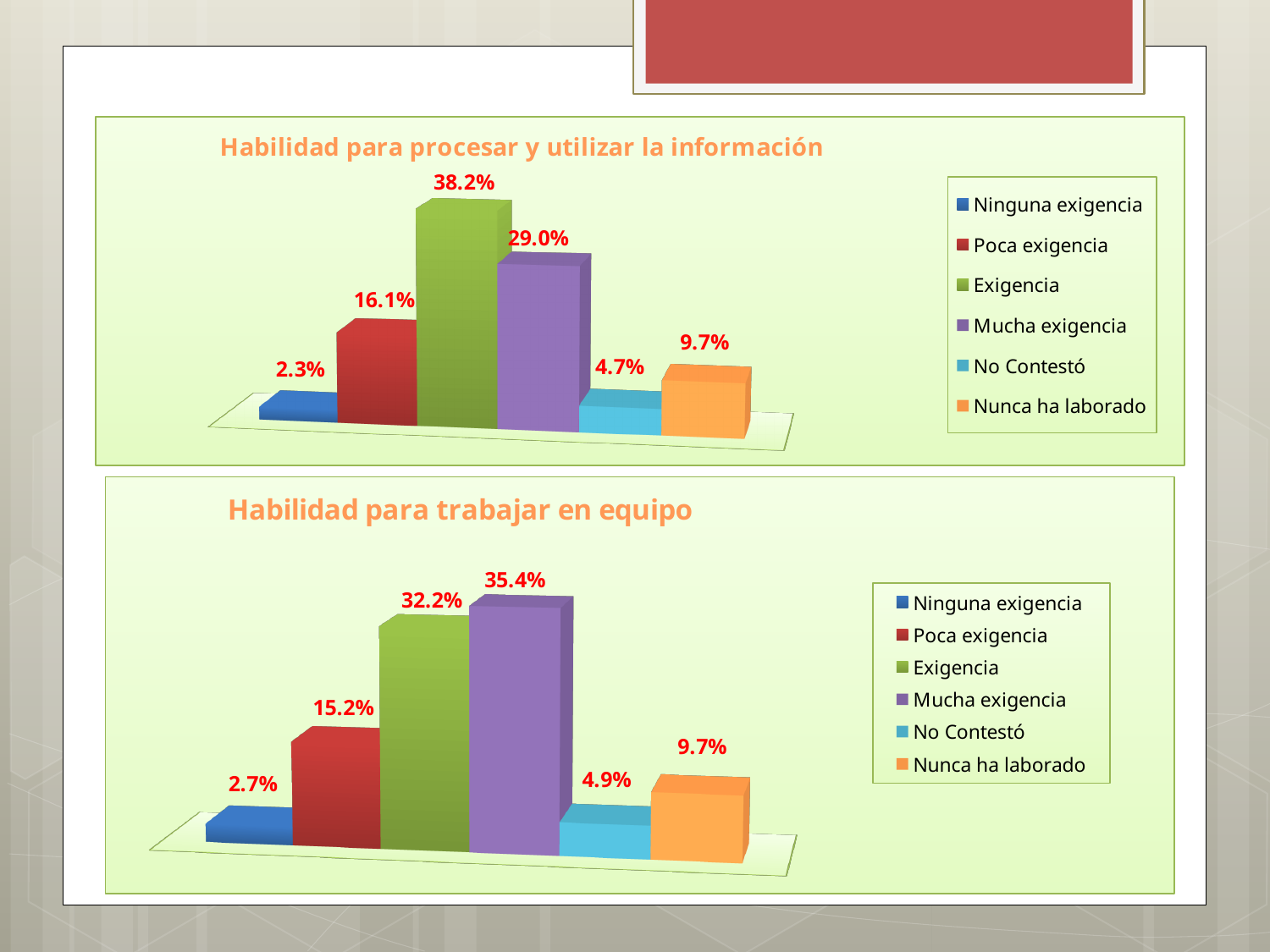
What kind of chart is the chart titled 'Habilidad para procesar y utilizar la información'? Bar chart In the chart titled 'Habilidad para trabajar en equipo', which category has the highest value? Mucha exigencia In the chart titled 'Habilidad para procesar y utilizar la información', what is the value for Exigencia? 38.2% In the chart titled 'Habilidad para trabajar en equipo', which category has the lowest value? Ninguna exigencia In the chart titled 'Habilidad para trabajar en equipo', what is the value for Mucha exigencia? 35.4% In the chart titled 'Habilidad para procesar y utilizar la información', which category has the highest value? Exigencia In the chart titled 'Habilidad para procesar y utilizar la información', what is the value for Poca exigencia? 16.1% In the chart titled 'Habilidad para trabajar en equipo', what is the value for No Contestó? 4.9% In the chart titled 'Habilidad para trabajar en equipo', what is the difference between the values for Poca exigencia and Ninguna exigencia? 12.5% In the chart titled 'Habilidad para procesar y utilizar la información', which is larger, the value for Nunca ha laborado or the value for No Contestó? Nunca ha laborado How many entries does the legend of the chart titled 'Habilidad para trabajar en equipo' list? 6 In the chart titled 'Habilidad para procesar y utilizar la información', what is the difference between the values for Exigencia and Mucha exigencia? 9.2%